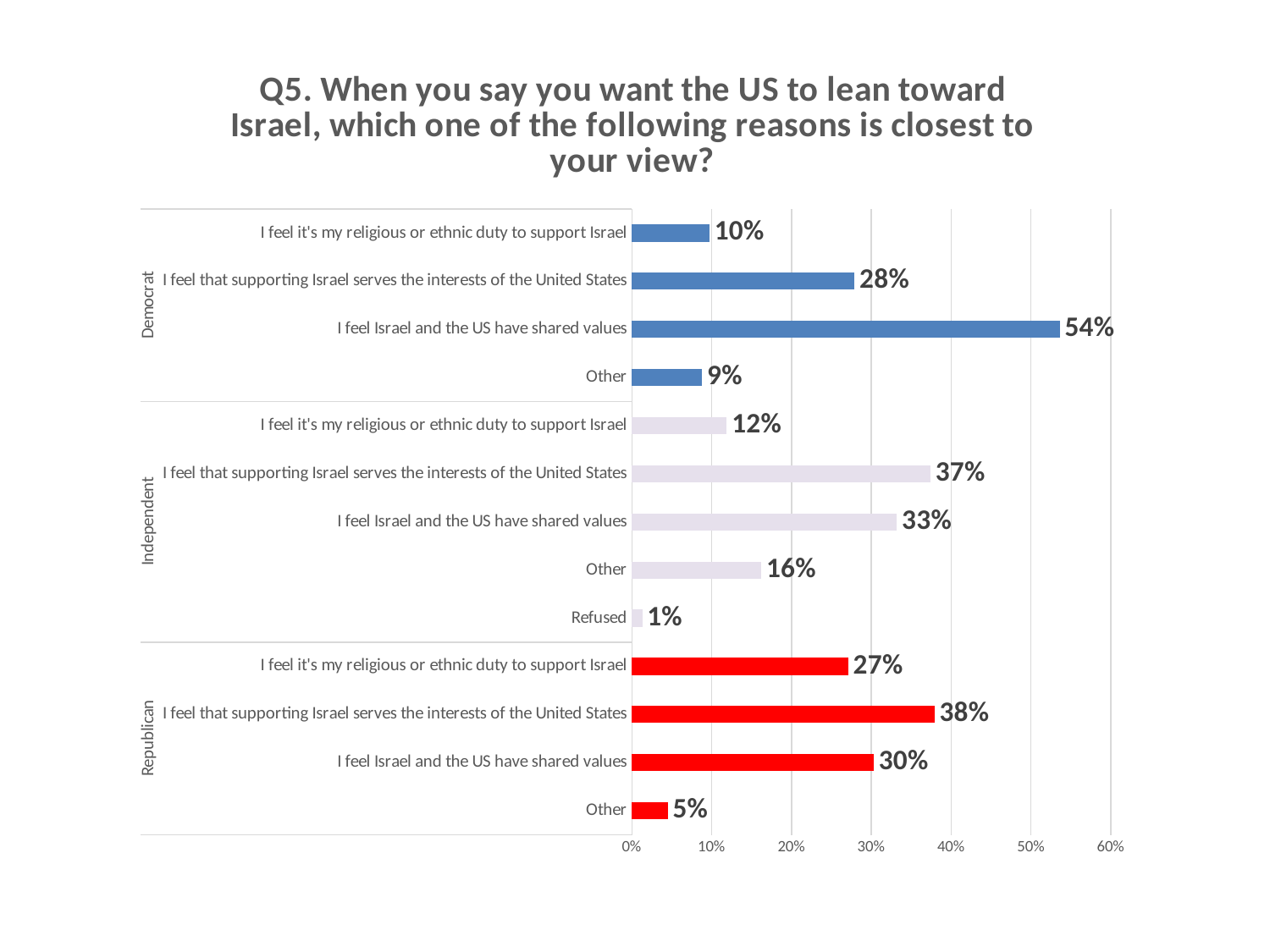
What percentage of Republicans say they feel it's their religious or ethnic duty to support Israel? 27% What is the difference between the Republican and Democrat values for 'I feel it's my religious or ethnic duty to support Israel'? 17% How many bars are plotted in the Independent group? 5 What percentage of Independents refused to answer? 1% What colour are the bars for the Republican group? Red What percentage of Democrats say they feel Israel and the US have shared values? 54% What is the highest value shown on the x axis? 60% What percentage of Independents chose 'Other'? 16% Which is larger: the Independent value for 'I feel that supporting Israel serves the interests of the United States' or the Independent value for 'I feel Israel and the US have shared values'? I feel that supporting Israel serves the interests of the United States What type of chart is shown on the slide? Bar chart Which reason has the highest value among Democrats? I feel Israel and the US have shared values Which reason has the lowest value among Republicans? Other